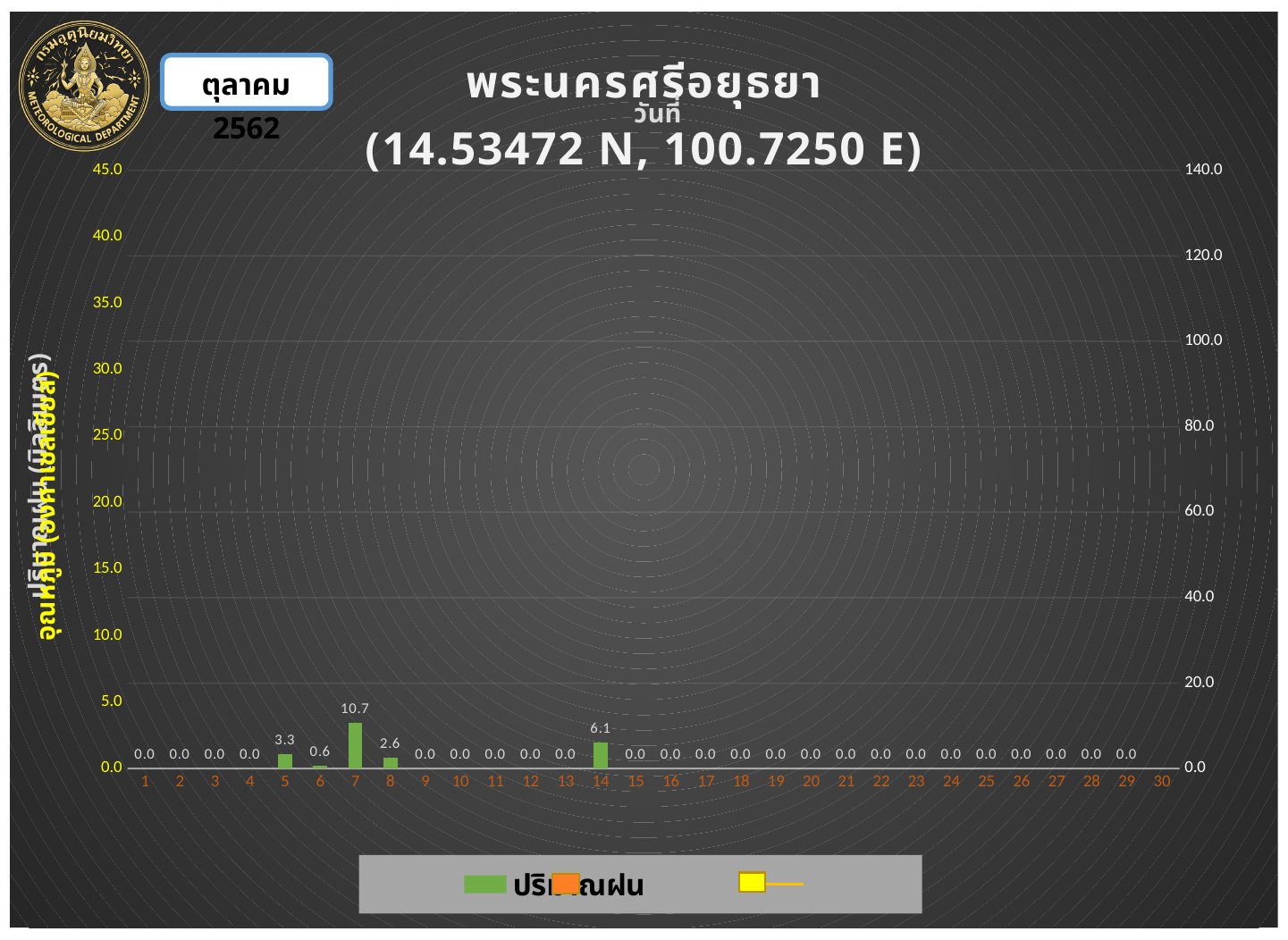
What is the rainfall value shown for day 5? 3.3 What is the rainfall value shown for day 6? 0.6 What is the rainfall value shown for day 8? 2.6 How many days are shown on the x axis? 30 What kind of chart is used to show the rainfall values? bar chart What is the rainfall value shown for day 7? 10.7 What is the total rainfall for days 5 through 8? 17.2 Which is larger, the rainfall value for day 5 or for day 8? day 5 What is the difference between the rainfall values for day 7 and day 14? 4.6 Which day has the highest rainfall value? 7 What is the rainfall value shown for day 14? 6.1